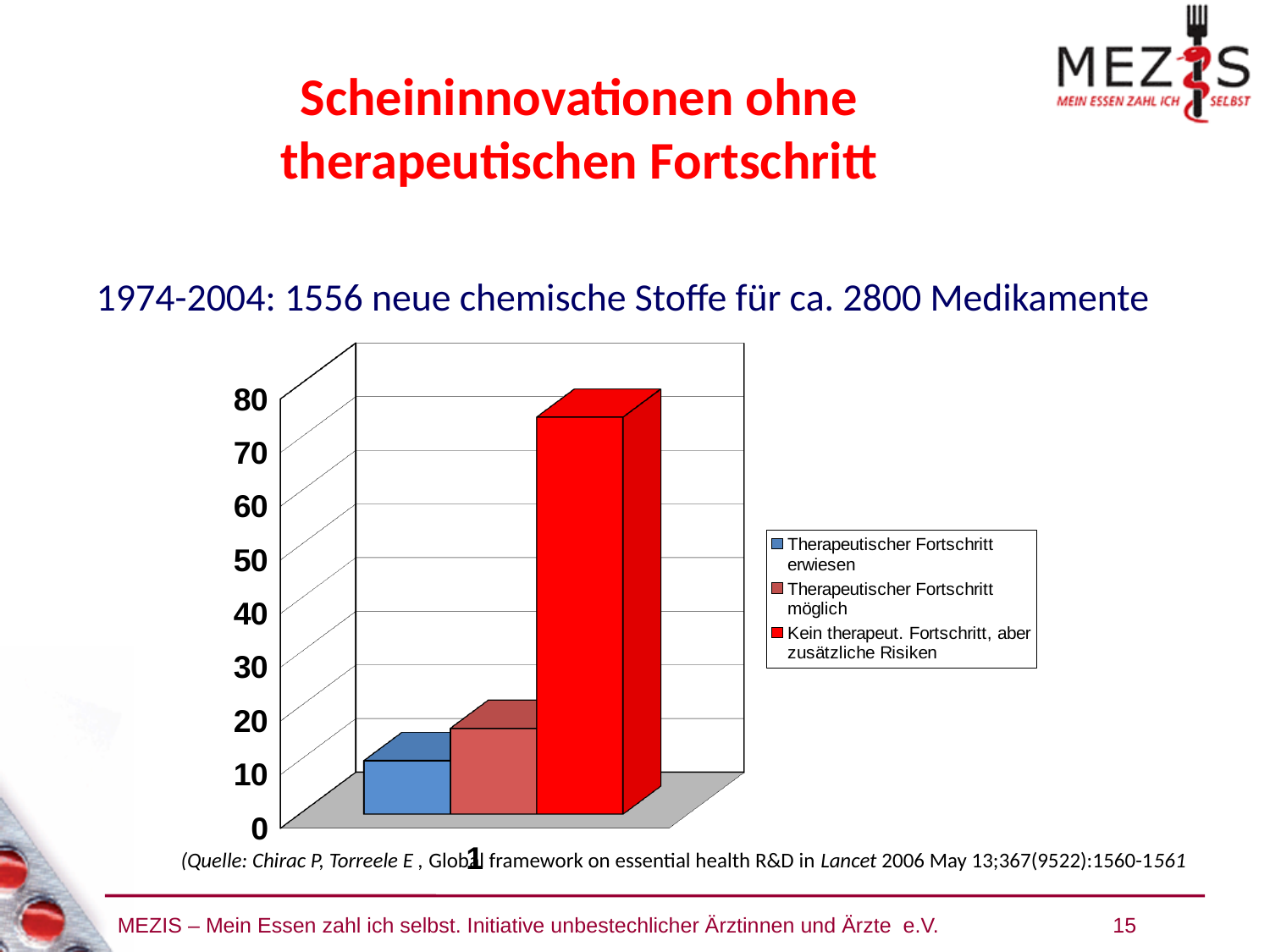
Which series has the highest bar? Kein therapeut. Fortschritt, aber zusätzliche Risiken Is the value for "Therapeutischer Fortschritt erwiesen" greater or less than 20? less What kind of chart is shown on the slide? bar chart Is the value for "Therapeutischer Fortschritt möglich" greater or less than 30? less What colour is the bar for "Kein therapeut. Fortschritt, aber zusätzliche Risiken"? red Is the value for "Kein therapeut. Fortschritt, aber zusätzliche Risiken" greater or less than 60? greater Which series has the lowest bar? Therapeutischer Fortschritt erwiesen What is the highest value shown on the vertical axis of the chart? 80 Which is larger, the bar for "Therapeutischer Fortschritt möglich" or the bar for "Therapeutischer Fortschritt erwiesen"? Therapeutischer Fortschritt möglich How many series does the legend list? 3 How many categories are shown on the x axis of the chart? 1